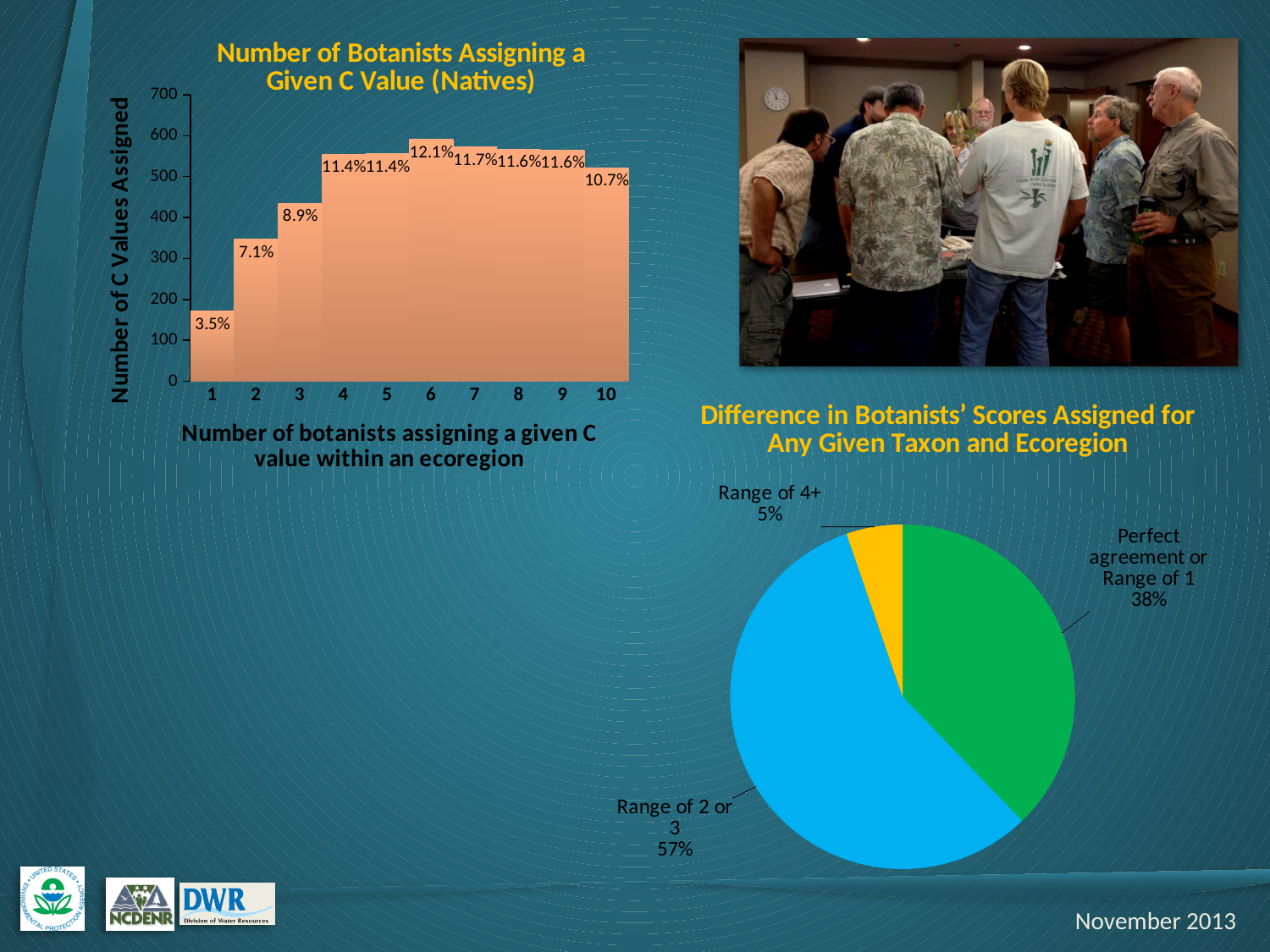
In the bar chart 'Number of Botanists Assigning a Given C Value (Natives)', what percentage label is shown on the bar for C value 6? 12.1% In the bar chart 'Number of Botanists Assigning a Given C Value (Natives)', is the value for C value 10 greater or less than 500? greater In the pie chart 'Difference in Botanists' Scores Assigned for Any Given Taxon and Ecoregion', which is larger: 'Perfect agreement or Range of 1' or 'Range of 2 or 3'? Range of 2 or 3 In the bar chart 'Number of Botanists Assigning a Given C Value (Natives)', what percentage label is shown on the bar for C value 10? 10.7% In the bar chart 'Number of Botanists Assigning a Given C Value (Natives)', which C value has the highest bar? 6 In the pie chart 'Difference in Botanists' Scores Assigned for Any Given Taxon and Ecoregion', what share is labelled for 'Range of 2 or 3'? 57% In the bar chart 'Number of Botanists Assigning a Given C Value (Natives)', how many C value categories are shown on the x axis? 10 In the bar chart 'Number of Botanists Assigning a Given C Value (Natives)', what percentage label is shown on the bar for C value 1? 3.5% In the bar chart 'Number of Botanists Assigning a Given C Value (Natives)', what is the difference between the percentage labels for C value 3 and C value 2? 1.8% In the bar chart 'Number of Botanists Assigning a Given C Value (Natives)', is the value for C value 1 greater or less than 200? less In the bar chart 'Number of Botanists Assigning a Given C Value (Natives)', which C value has the lowest bar? 1 In the pie chart 'Difference in Botanists' Scores Assigned for Any Given Taxon and Ecoregion', which slice is the smallest? Range of 4+